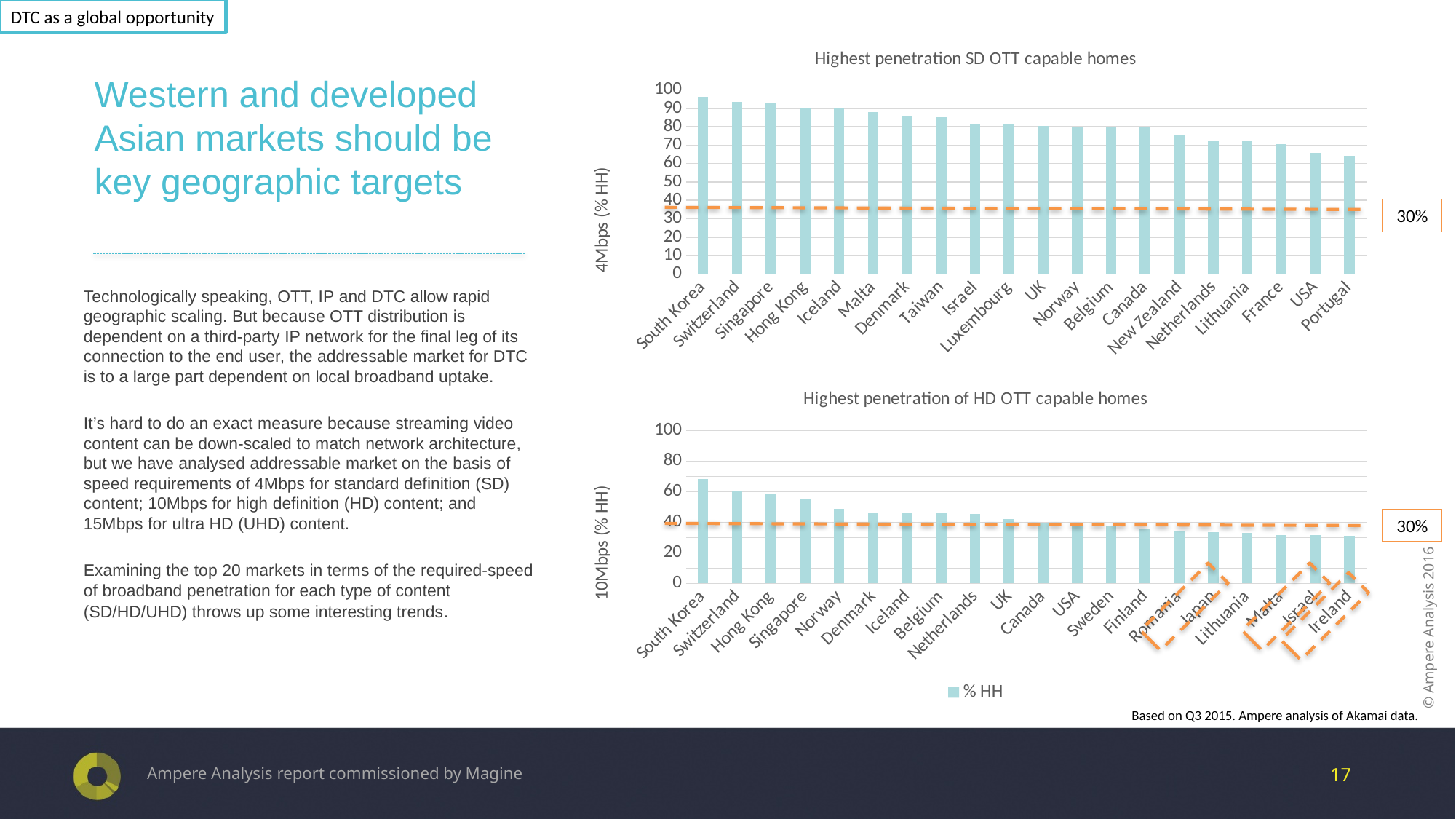
In the 'Highest penetration SD OTT capable homes' chart, is the value for Portugal greater or less than 60? greater In the 'Highest penetration SD OTT capable homes' chart, which country has the highest value? South Korea In the 'Highest penetration of HD OTT capable homes' chart, is the value for Romania greater or less than 40? less In the 'Highest penetration of HD OTT capable homes' chart, do the values rise or fall from left to right? fall In the 'Highest penetration SD OTT capable homes' chart, which is larger, the value for Switzerland or the value for Portugal? Switzerland In the 'Highest penetration of HD OTT capable homes' chart, is the value for South Korea greater or less than 60? greater In the 'Highest penetration SD OTT capable homes' chart, which country has the lowest value? Portugal In the 'Highest penetration of HD OTT capable homes' chart, which country has the lowest value? Ireland In the 'Highest penetration SD OTT capable homes' chart, how many countries are shown? 20 What kind of chart is the 'Highest penetration of HD OTT capable homes' chart? bar chart In the 'Highest penetration of HD OTT capable homes' chart, which country has the highest value? South Korea